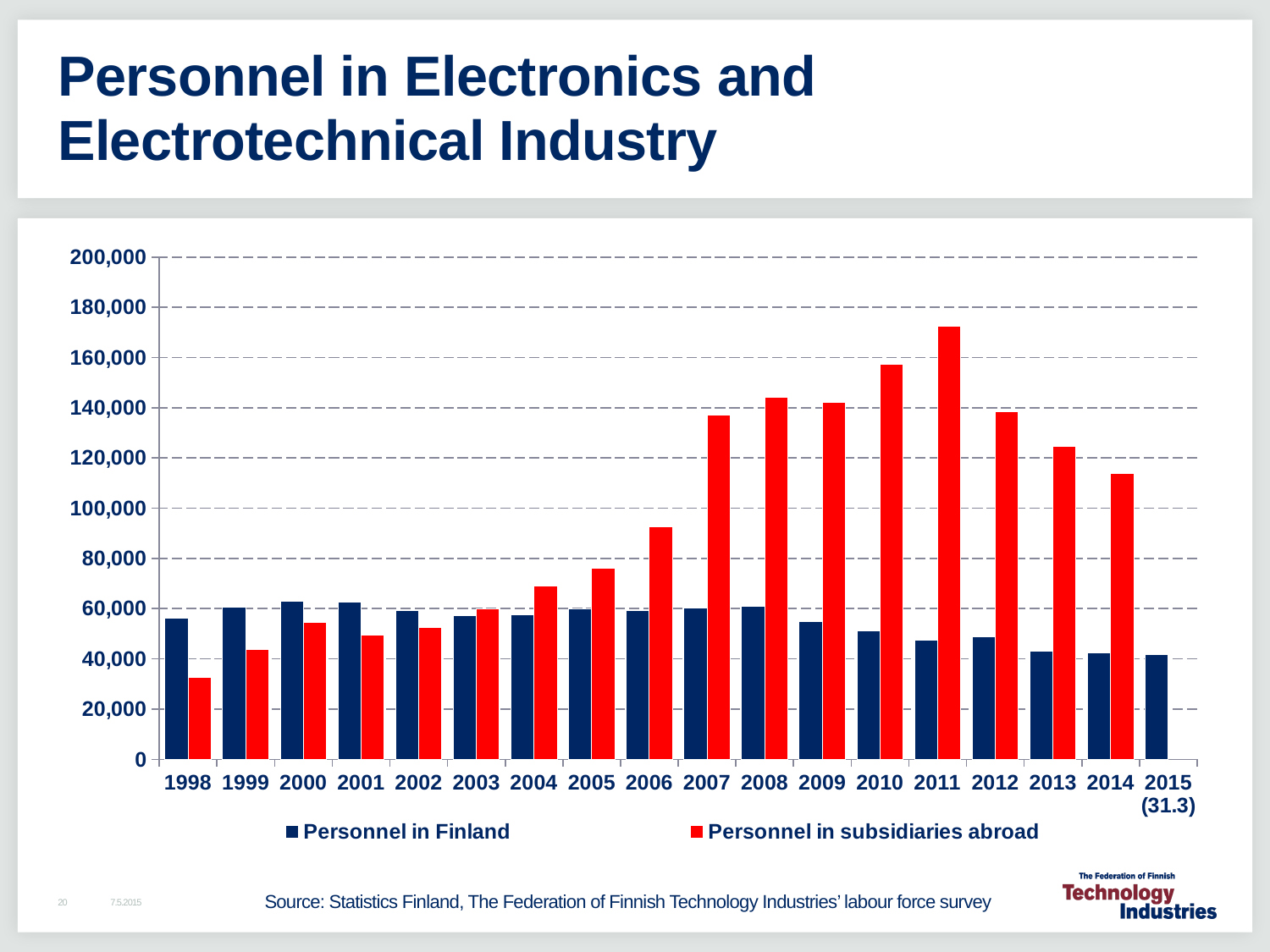
In which year is Personnel in subsidiaries abroad lowest? 1998 Is the value for Personnel in subsidiaries abroad in 2011 greater or less than 160,000? greater In which year is Personnel in subsidiaries abroad highest? 2011 Does Personnel in Finland rise or fall from 2008 to 2015 (31.3)? Fall What kind of chart is shown on the slide? Bar chart What colour are the bars for Personnel in subsidiaries abroad? Red How many series does the legend list? 2 In 2008, which is larger: Personnel in Finland or Personnel in subsidiaries abroad? Personnel in subsidiaries abroad Is the value for Personnel in subsidiaries abroad in 1998 greater or less than 40,000? less Is the value for Personnel in Finland in 2013 greater or less than 60,000? less How many years (categories) are shown on the x axis? 18